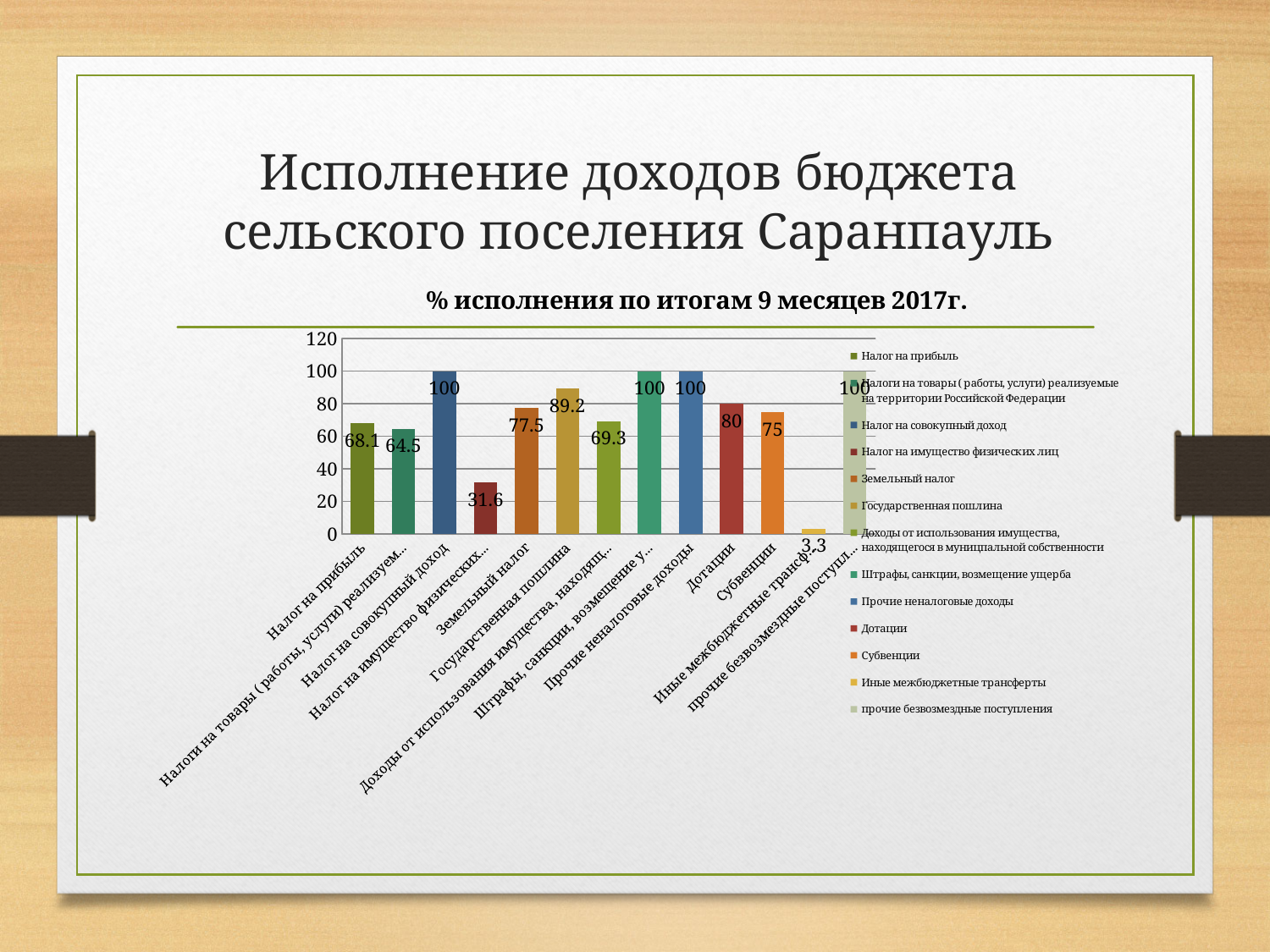
What kind of chart is shown on the slide? bar chart Which is larger, the value for Налог на прибыль or the value for Земельный налог? Земельный налог Which category has the lowest value? Иные межбюджетные трансферты How many entries does the legend list? 13 Is the value for Налог на имущество физических лиц greater or less than 40? less What is the value for Налог на прибыль? 68.1 What is the value for Государственная пошлина? 89.2 What is the value for Земельный налог? 77.5 What is the difference between the values for Дотации and Субвенции? 5 What is the title of the chart? % исполнения по итогам 9 месяцев 2017г. What is the value for Субвенции? 75 How many categories are plotted on the chart? 13